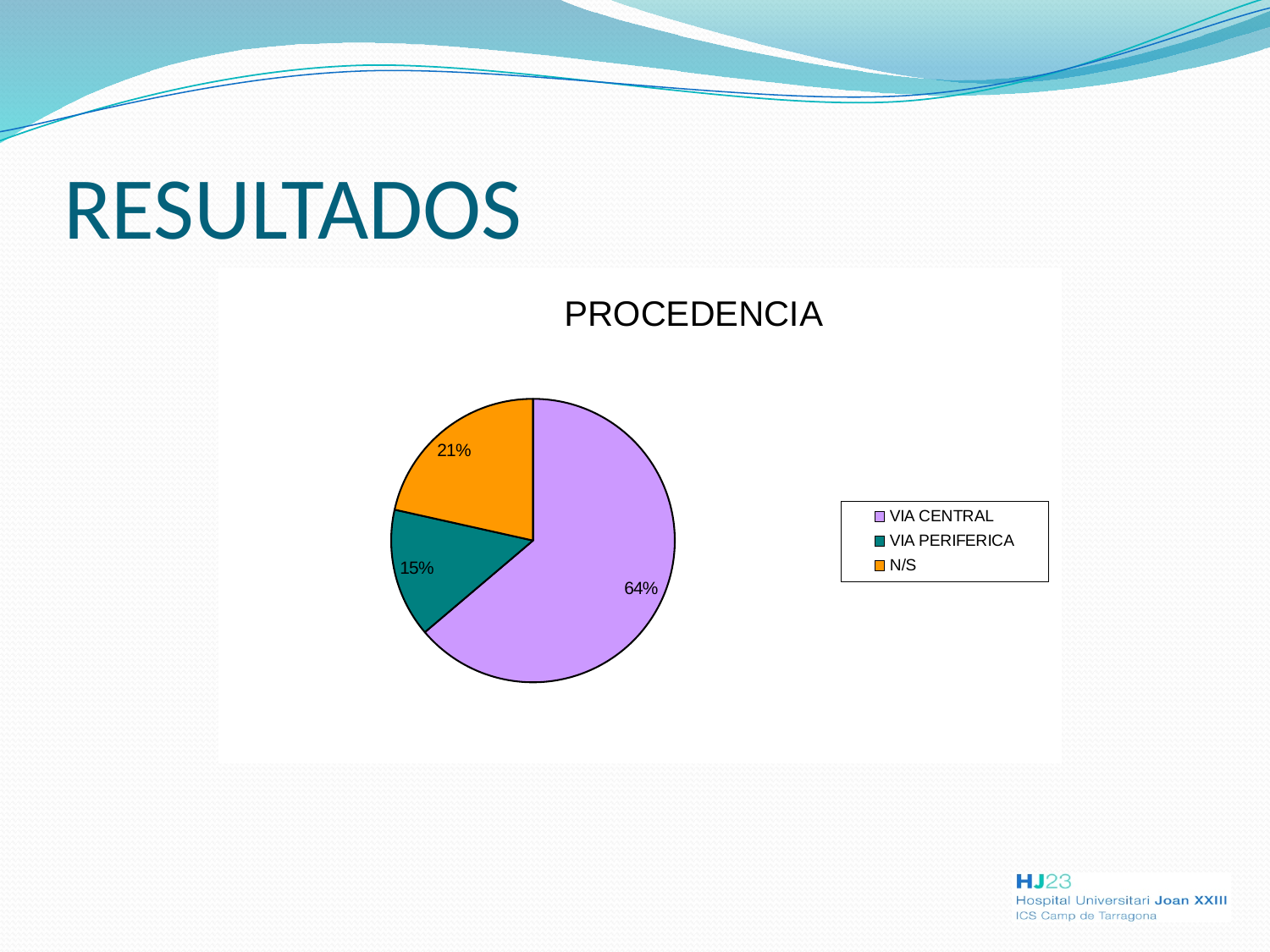
What is the title of the chart? PROCEDENCIA What share of the pie does VIA PERIFERICA represent? 15% What is the difference in percentage points between VIA CENTRAL and N/S? 43 Which category has the smallest slice of the pie? VIA PERIFERICA Which is larger, the share for N/S or the share for VIA PERIFERICA? N/S What share of the pie does VIA CENTRAL represent? 64% What share of the pie does N/S represent? 21% What colour is the VIA CENTRAL slice? Purple What type of chart is shown on the slide? Pie chart Which category has the largest slice of the pie? VIA CENTRAL What is the difference in percentage points between N/S and VIA PERIFERICA? 6 How many categories are shown in the pie chart? 3